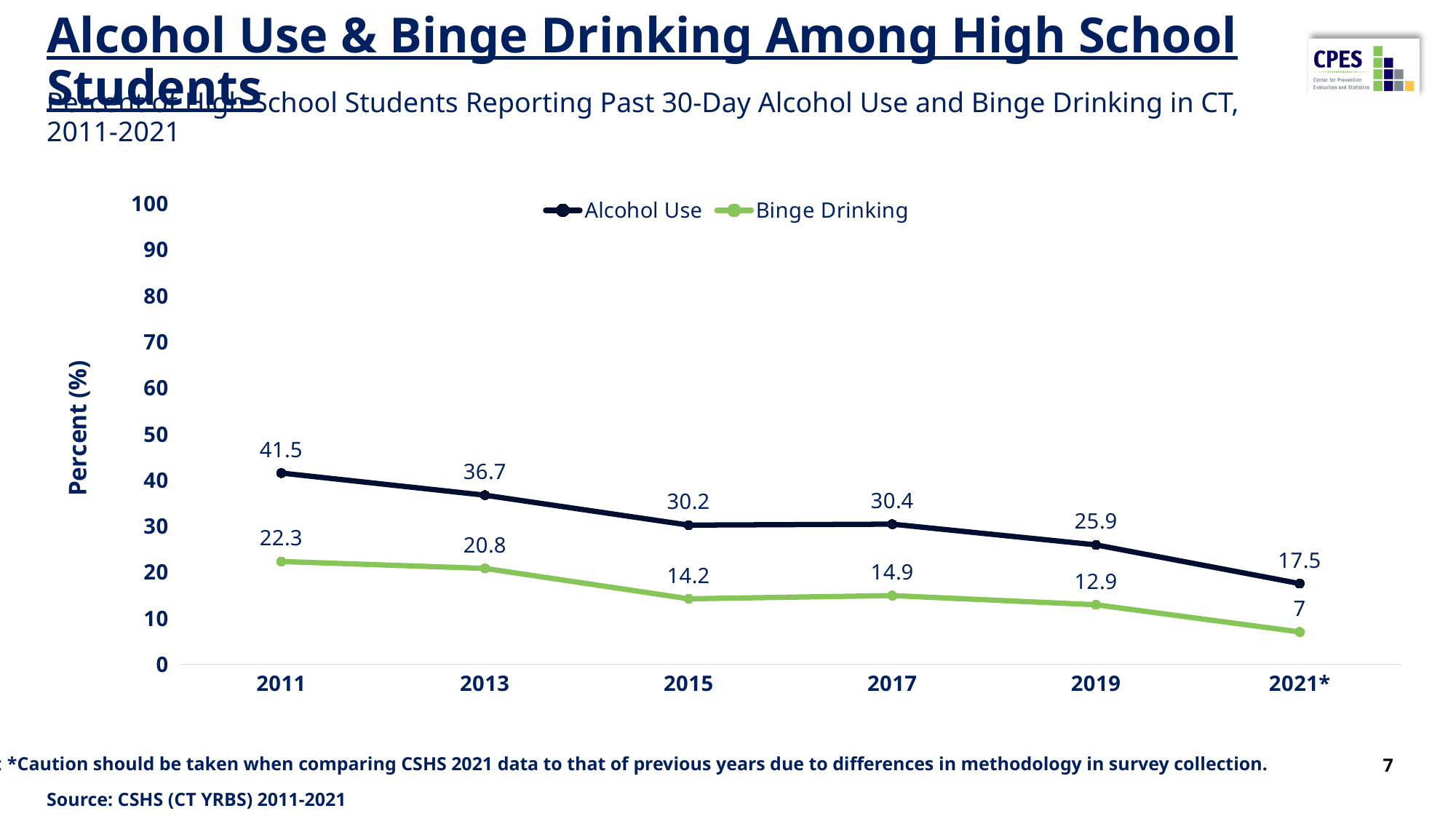
Is the alcohol use value for 2013 greater or less than 30? greater How many years are shown on the x axis? 6 Which was higher for alcohol use: 2015 or 2017? 2017 What is the difference between alcohol use and binge drinking in 2019? 13 What is the overall trend of binge drinking from 2011 to 2021*? falling What was the binge drinking value in 2021*? 7 How many series does the legend list? 2 What was the percent of high school students reporting past 30-day alcohol use in 2011? 41.5 What kind of chart is shown? line chart What was the binge drinking percentage in 2017? 14.9 In which year was binge drinking lowest? 2021* In which year was alcohol use highest? 2011